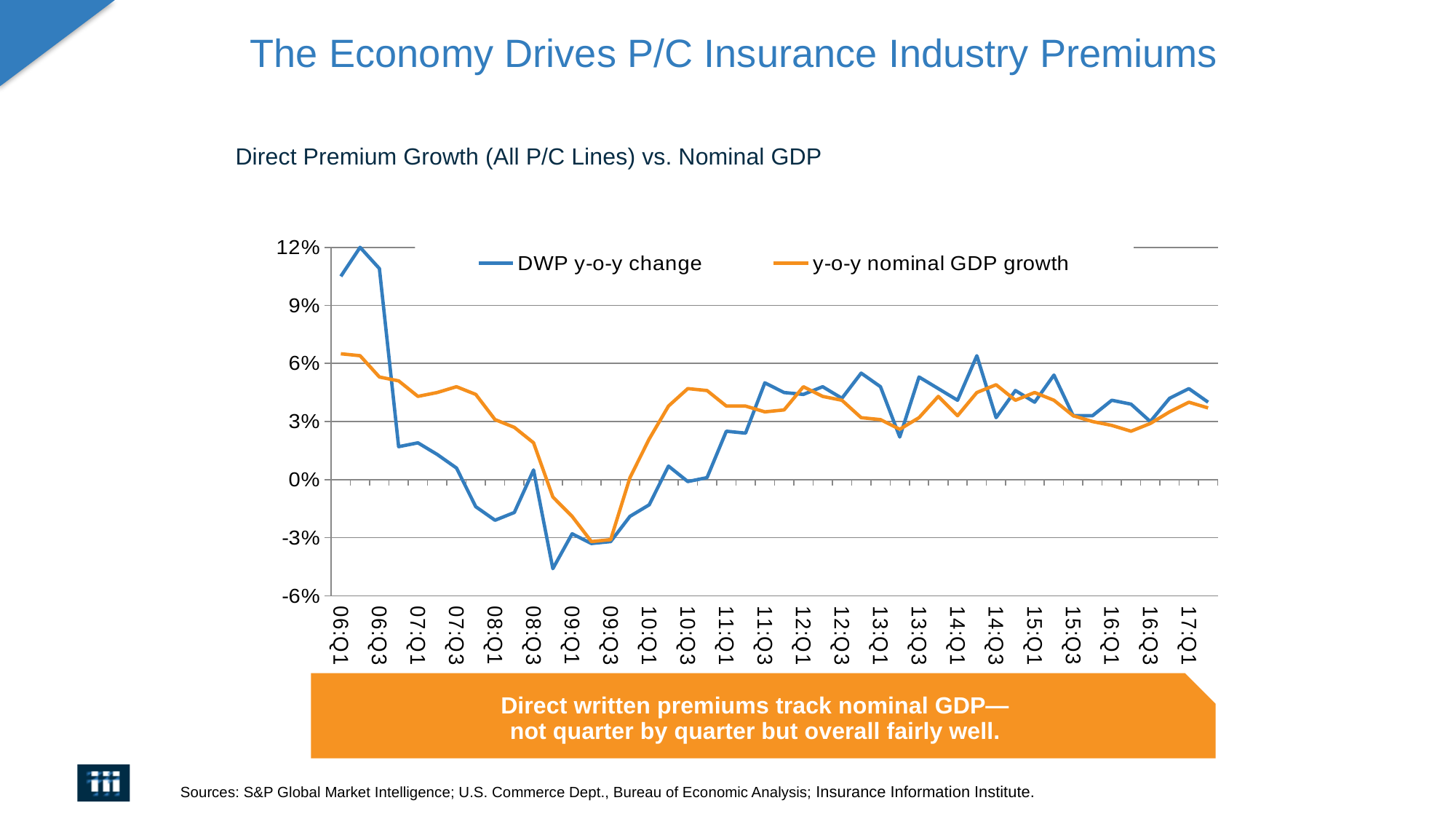
What are the two series named in the legend? DWP y-o-y change; y-o-y nominal GDP growth Is the y-o-y nominal GDP growth at 06:Q1 greater or less than 6%? greater Does the y-o-y nominal GDP growth rise or fall between 09:Q3 and 10:Q3? rise What is the title of the chart? Direct Premium Growth (All P/C Lines) vs. Nominal GDP At 06:Q1, which series has the higher value, DWP y-o-y change or y-o-y nominal GDP growth? DWP y-o-y change At 08:Q1, which series has the higher value, DWP y-o-y change or y-o-y nominal GDP growth? y-o-y nominal GDP growth How many series does the legend list? 2 Is the y-o-y nominal GDP growth at 09:Q3 greater or less than 0%? less Does the DWP y-o-y change rise or fall between 06:Q3 and 07:Q1? fall Is the DWP y-o-y change at 06:Q1 greater or less than 9%? greater What kind of chart is shown on the slide? Line chart